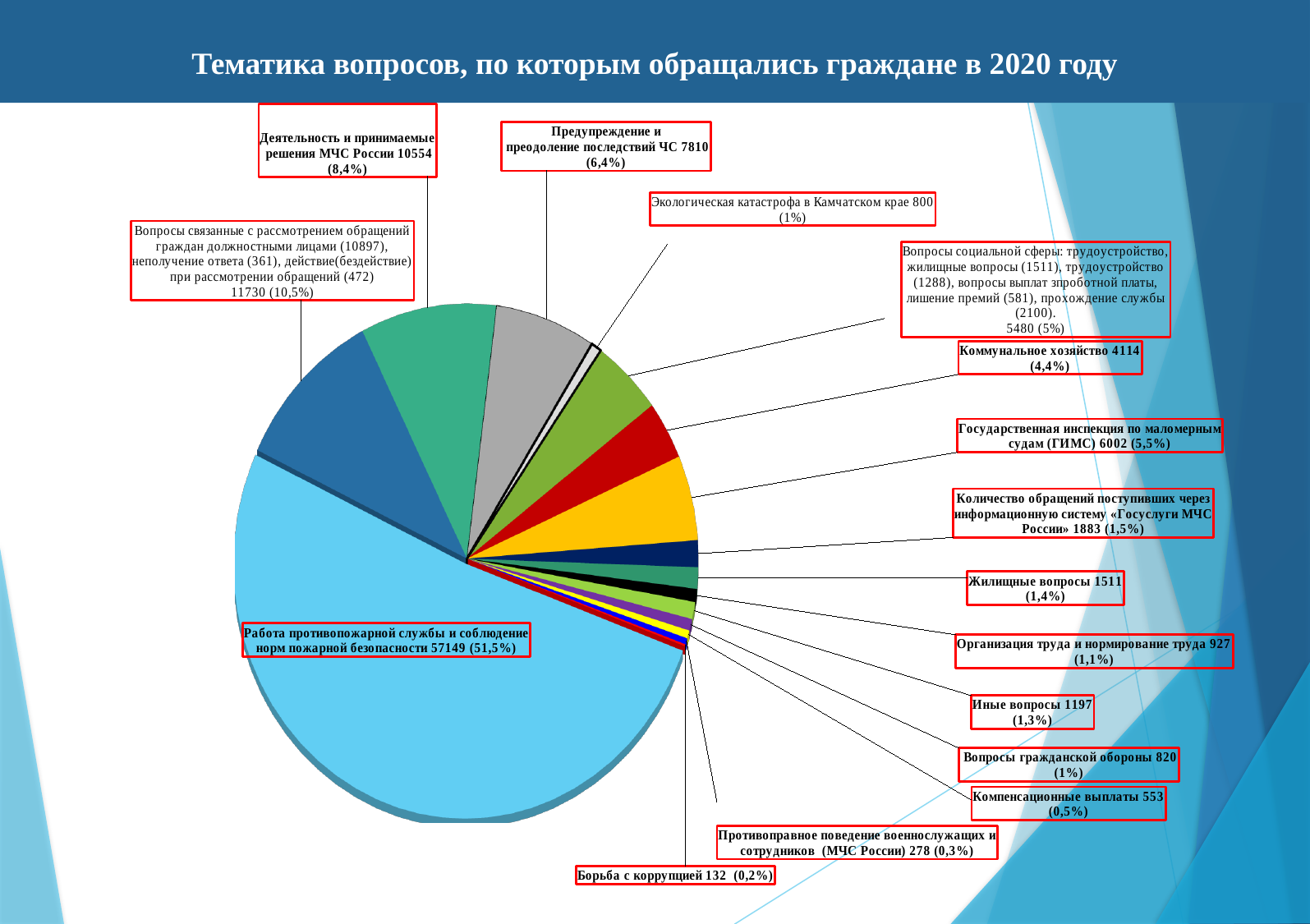
What is the difference between the values for «Государственная инспекция по маломерным судам (ГИМС)» and «Вопросы социальной сферы»? 522 What type of chart is shown on the slide? pie chart What is the title of the chart on the slide? Тематика вопросов, по которым обращались граждане в 2020 году What percentage is shown for «Государственная инспекция по маломерным судам (ГИМС)»? 5,5% How many categories are labelled on the pie chart? 16 What is the difference between the values for «Жилищные вопросы» and «Иные вопросы»? 314 Which is larger: «Предупреждение и преодоление последствий ЧС» or «Деятельность и принимаемые решения МЧС России»? Деятельность и принимаемые решения МЧС России Which category has the largest slice of the pie? Работа противопожарной службы и соблюдение норм пожарной безопасности What share of the pie does «Работа противопожарной службы и соблюдение норм пожарной безопасности» take? 51,5% What value is shown for «Коммунальное хозяйство»? 4114 How many appeals are shown for «Работа противопожарной службы и соблюдение норм пожарной безопасности»? 57149 Which category has the smallest slice of the pie? Борьба с коррупцией